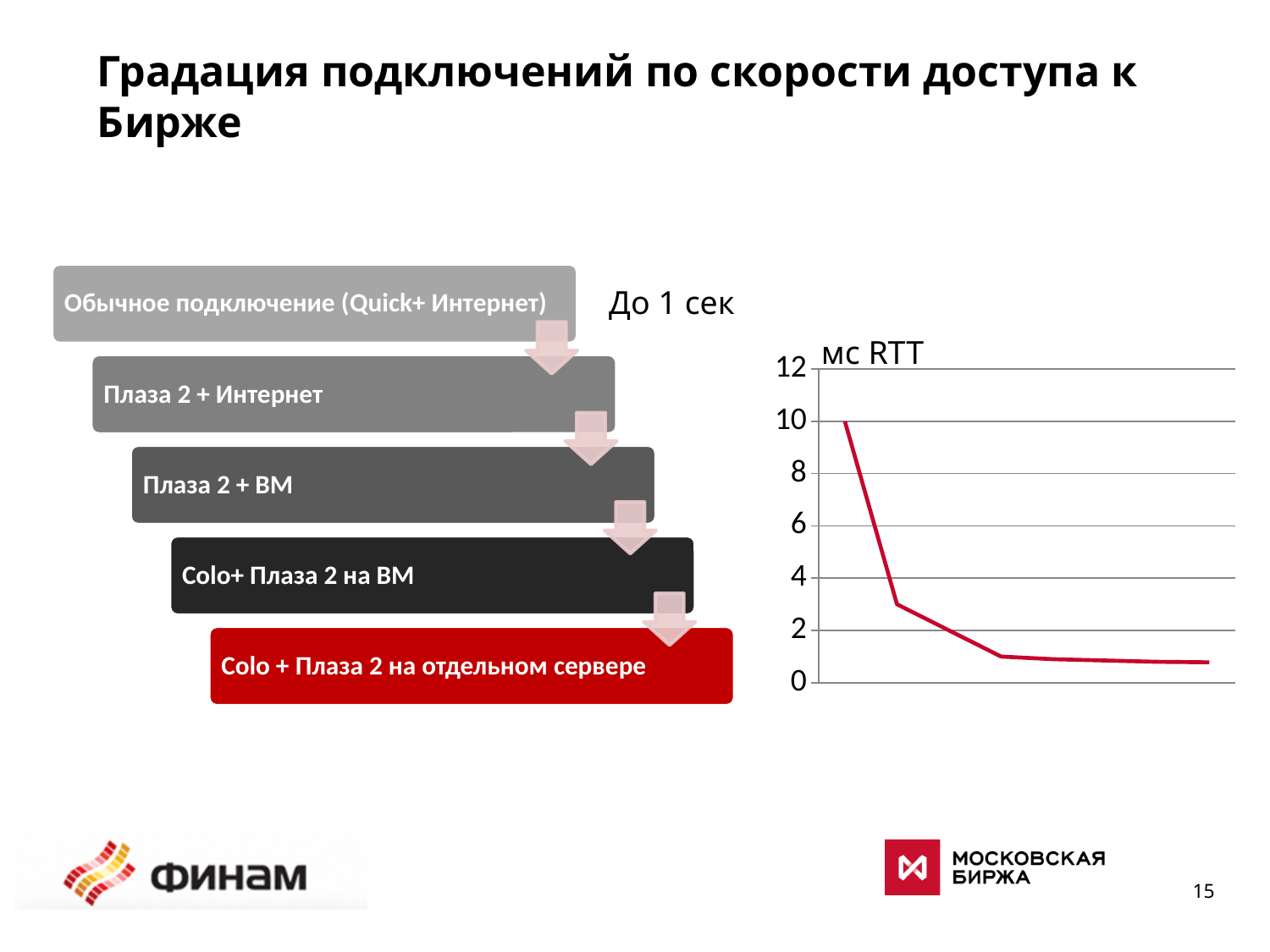
In the "мс RTT" chart, is the value of the second point greater or less than 2? greater What kind of chart is the "мс RTT" chart? line chart In the "мс RTT" chart, is the value of the last (rightmost) point greater or less than 2? less In the "мс RTT" chart, is the value of the second point greater or less than 4? less In the "мс RTT" chart, which point has the highest value, the first or the last? the first What is the highest value shown on the y axis of the "мс RTT" chart? 12 What is the title of the line chart on the slide? мс RTT In the "мс RTT" chart, do the values rise or fall from left to right? fall